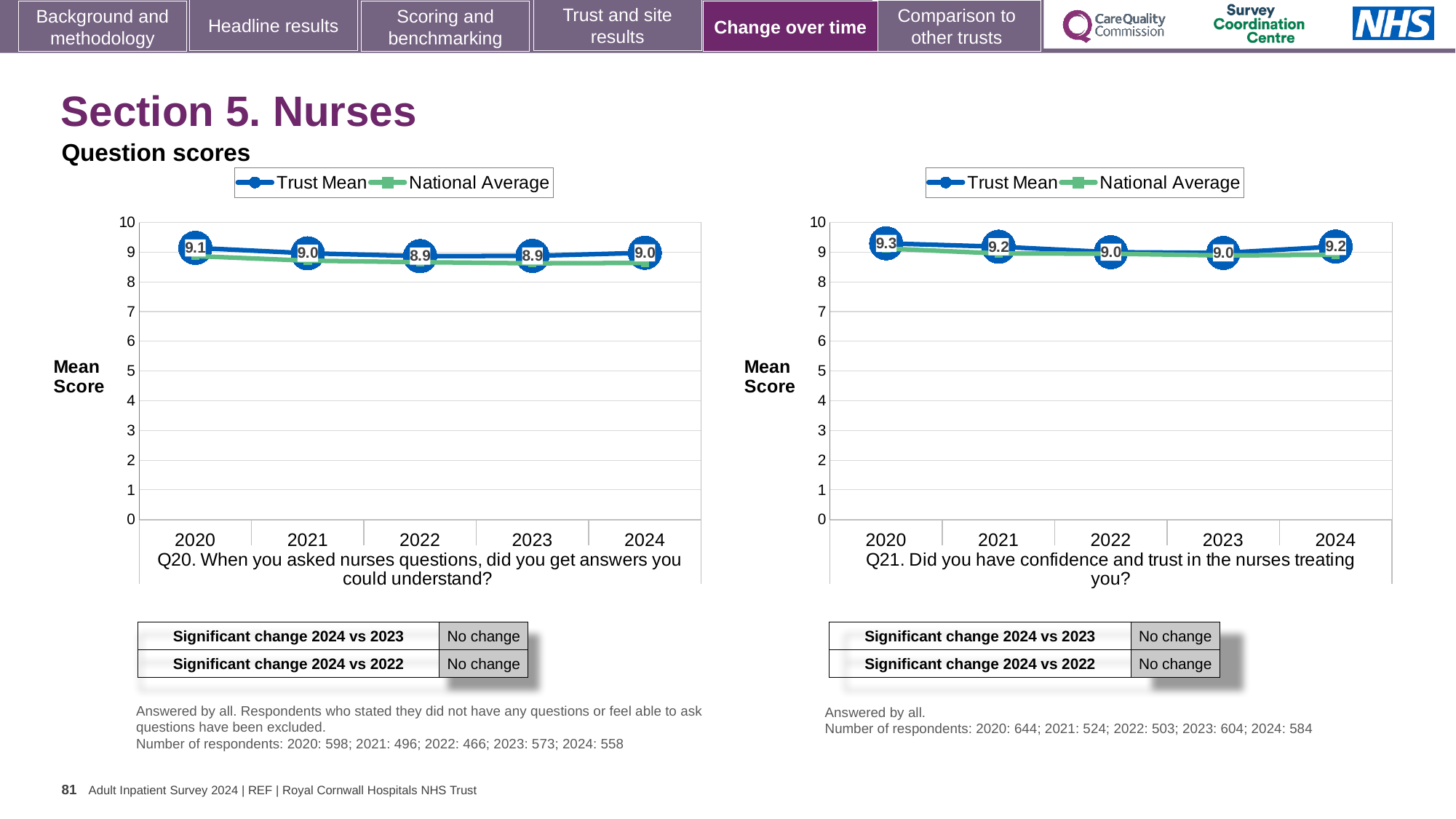
How many series does the legend of the Q21 chart on the right list? 2 In the Q21 chart on the right, is the National Average value for 2022 greater or less than 8? greater In the Q21 chart on the right, does the Trust Mean score rise or fall from 2020 to 2022? fall In the Q21 chart on the right, what is the difference between the Trust Mean scores for 2020 and 2022? 0.3 How many years are plotted on the x axis of the Q20 chart on the left? 5 In the Q20 chart on the left, which year has the highest Trust Mean score? 2020 In the Q20 chart on the left, what is the Trust Mean score for 2020? 9.1 What kind of chart is the Q20 chart on the left? line chart In the Q21 chart on the right, what is the Trust Mean score for 2024? 9.2 In the Q20 chart on the left, is the Trust Mean score for 2021 larger or smaller than the score for 2023? larger In the Q20 chart on the left, what is the Trust Mean score for 2022? 8.9 In the Q21 chart on the right, which year has the highest Trust Mean score? 2020